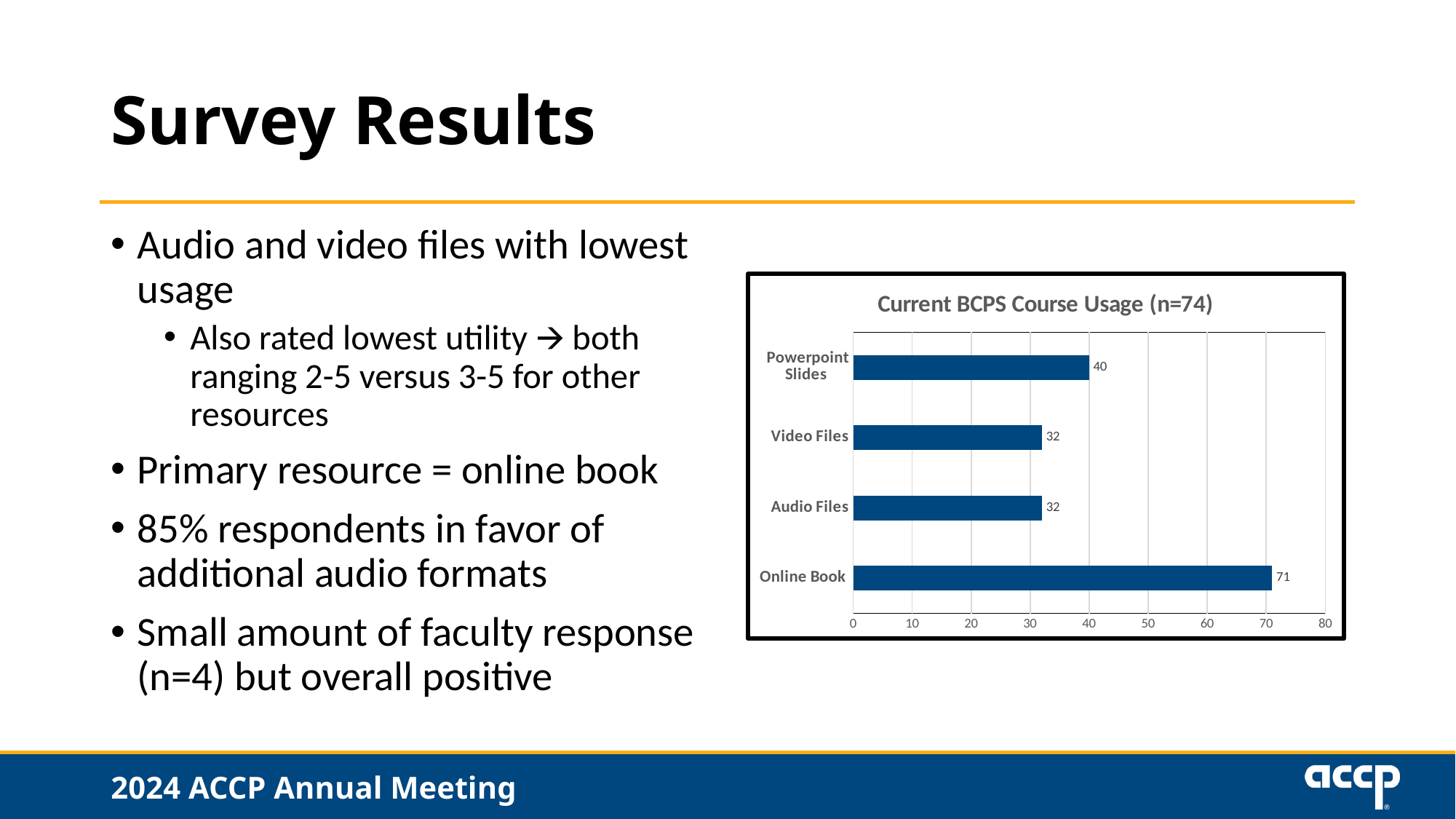
How many categories are shown in the Current BCPS Course Usage chart? 4 Which is larger, the value for Powerpoint Slides or the value for Video Files? Powerpoint Slides What is the maximum value shown on the x axis of the chart? 80 What is the difference between the values for Online Book and Powerpoint Slides? 31 Which category has the highest value in the Current BCPS Course Usage chart? Online Book What is the value for Online Book in the Current BCPS Course Usage chart? 71 What is the value for Video Files in the Current BCPS Course Usage chart? 32 What is the title of the chart on the slide? Current BCPS Course Usage (n=74) Is the value for Online Book greater or less than 60? greater What kind of chart is shown on the slide? Bar chart What is the difference between the values for Powerpoint Slides and Audio Files? 8 What is the value for Powerpoint Slides in the Current BCPS Course Usage chart? 40